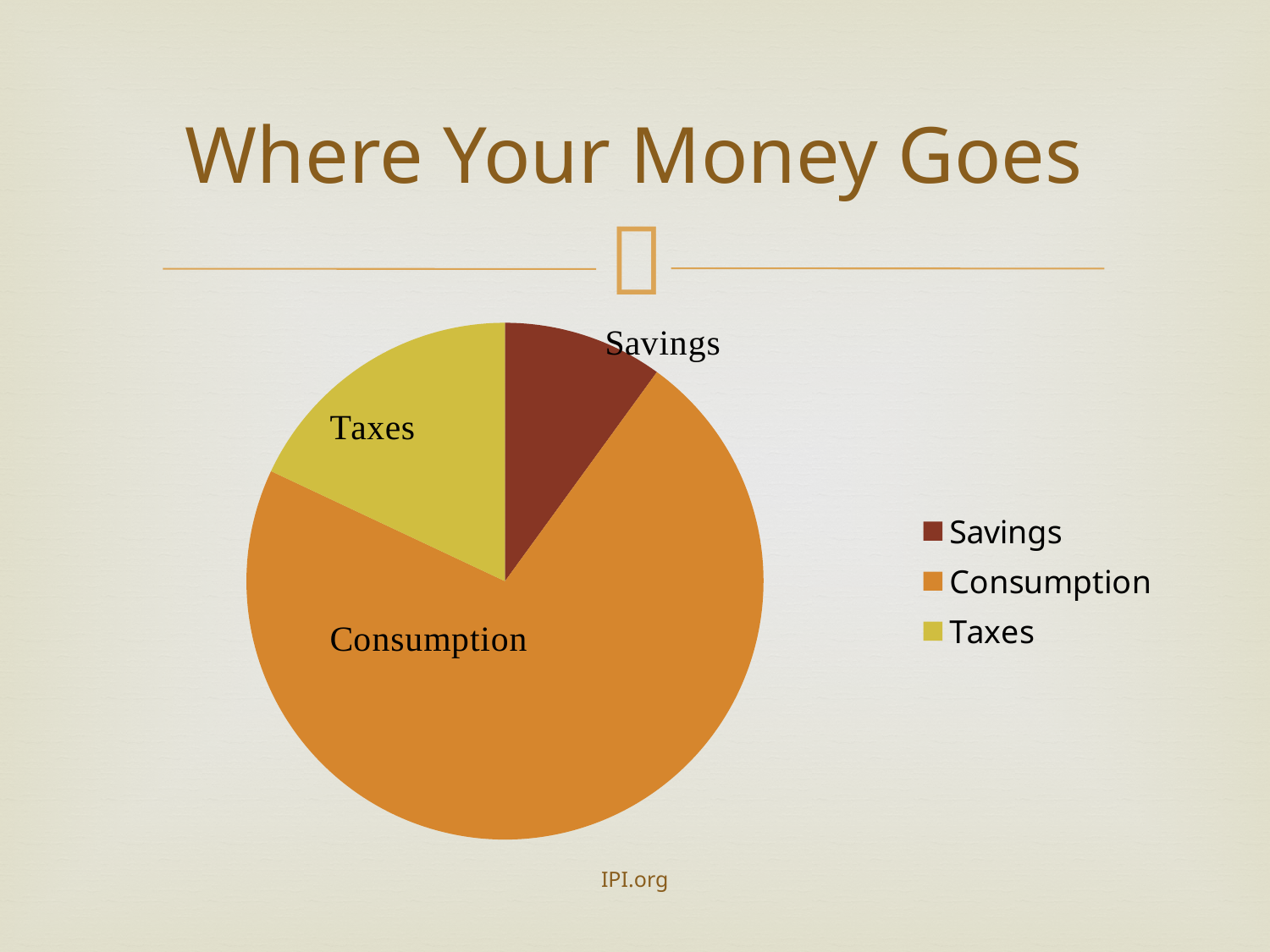
How many slices does the pie chart have? 3 Which slice is larger, Taxes or Savings? Taxes Which category takes the largest share of the pie? Consumption What colour is the Taxes slice in the pie chart? Yellow How many entries does the legend list? 3 Which category takes the smallest share of the pie? Savings Which slice is larger, Consumption or Taxes? Consumption Does Consumption account for more or less than half of the pie? More What is the title of the chart on the slide? Where Your Money Goes What kind of chart is shown on the slide? Pie chart